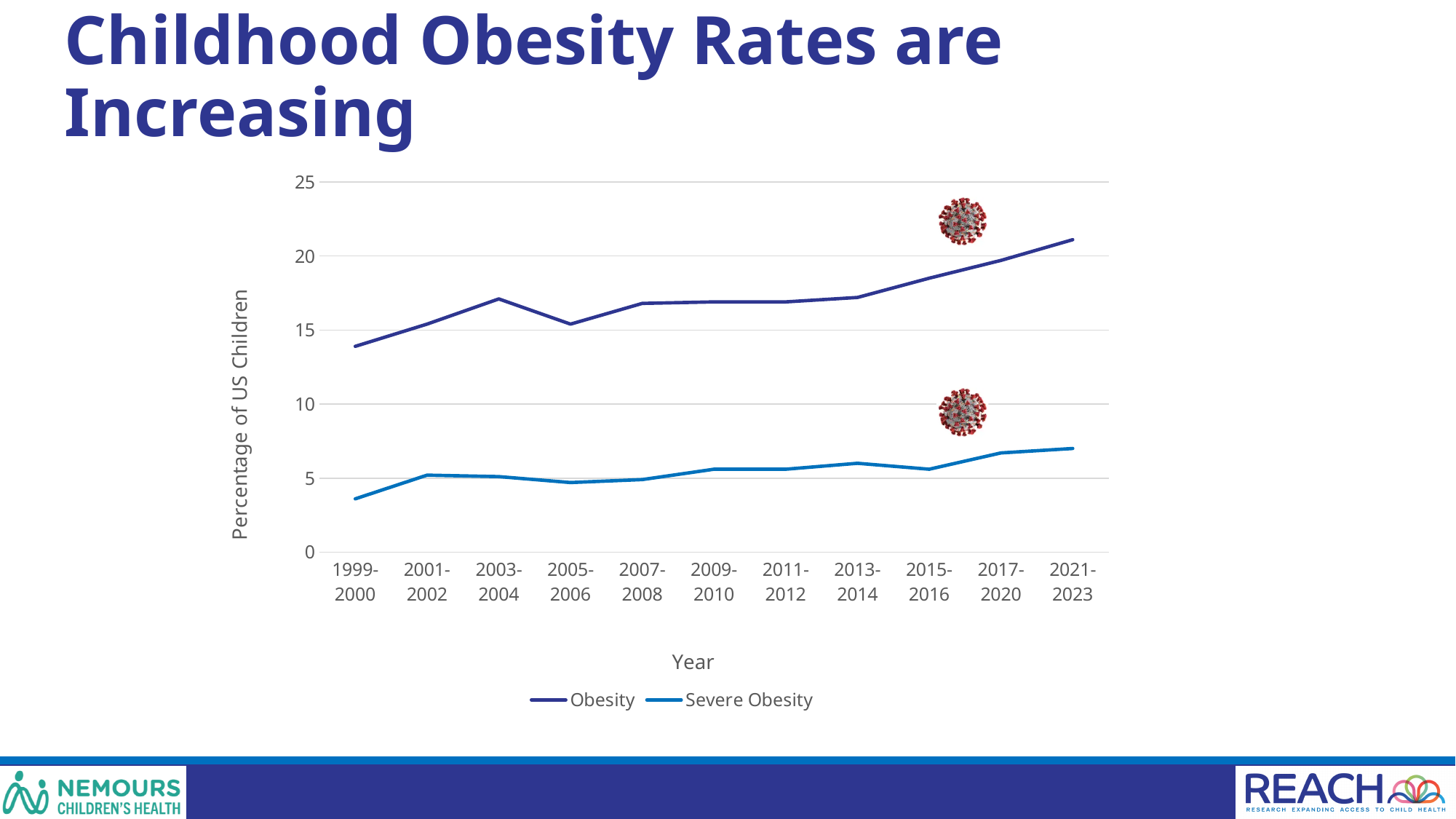
Is the Obesity value for 2021-2023 greater or less than 20? greater What is the title of the slide containing the chart? Childhood Obesity Rates are Increasing How many year periods are shown along the x axis? 11 In which year period is the Severe Obesity series at its lowest? 1999-2000 In which year period is the Obesity series at its highest? 2021-2023 Which is larger, the Obesity value for 2003-2004 or for 2005-2006? 2003-2004 Is the Severe Obesity value for 1999-2000 greater or less than 5? less In which year period is the Obesity series at its lowest? 1999-2000 What is the label of the vertical axis? Percentage of US Children How many series does the legend list? 2 What kind of chart is shown on the slide? Line chart Overall, does the Obesity series rise or fall from 1999-2000 to 2021-2023? Rise